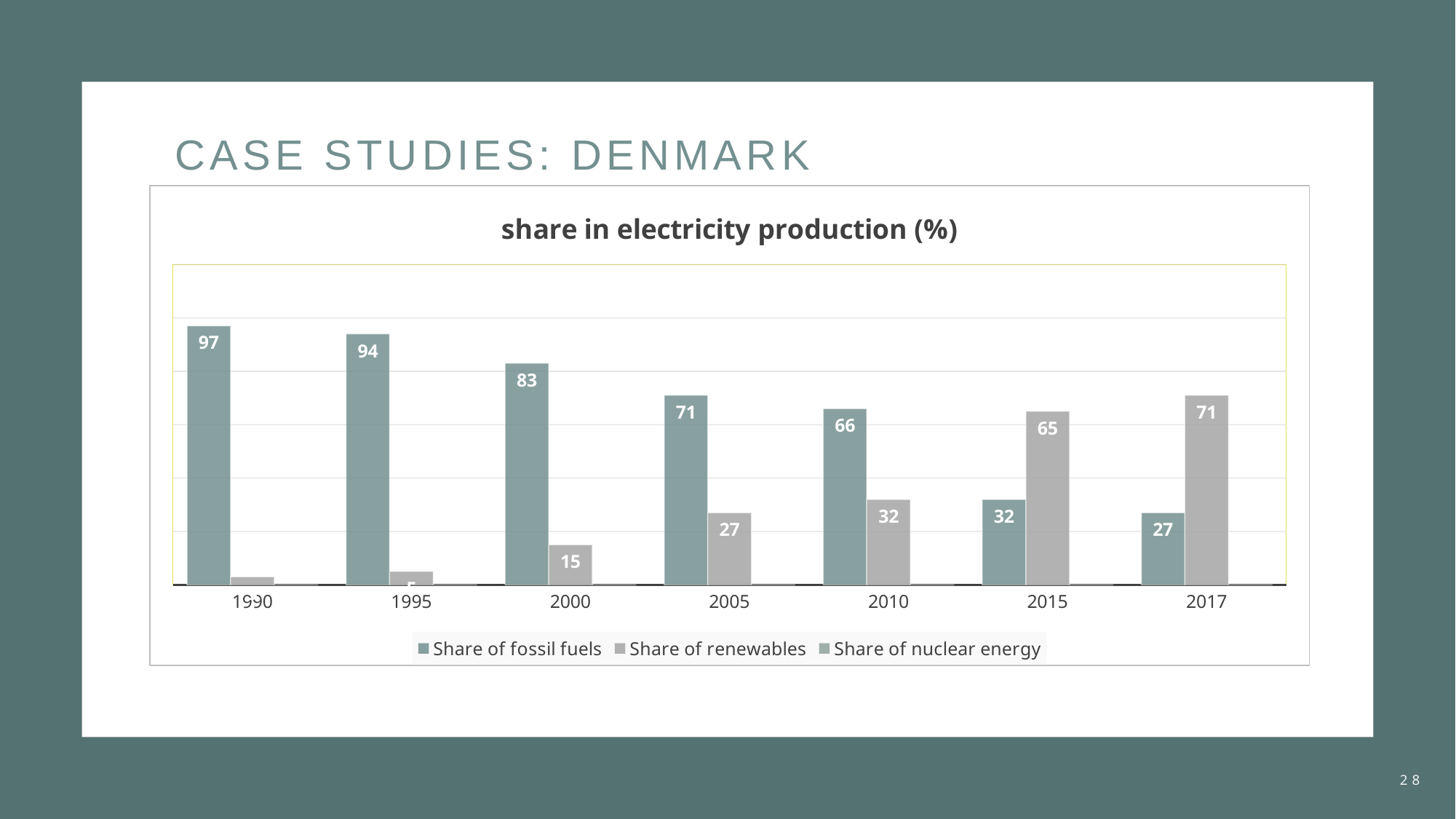
In 2010, which is larger: the share of fossil fuels or the share of renewables? Share of fossil fuels Does the share of fossil fuels rise or fall from 1990 to 2017? Fall What kind of chart is shown on the slide? Bar chart What is the share of renewables in 2017? 71 What is the share of renewables in 2000? 15 What is the difference between the share of renewables and the share of fossil fuels in 2015? 33 What is the share of fossil fuels in 1990? 97 How many series does the legend list? 3 What is the share of fossil fuels in 2005? 71 How many years are shown on the x axis? 7 In which year is the share of fossil fuels lowest? 2017 In which year is the share of fossil fuels highest? 1990